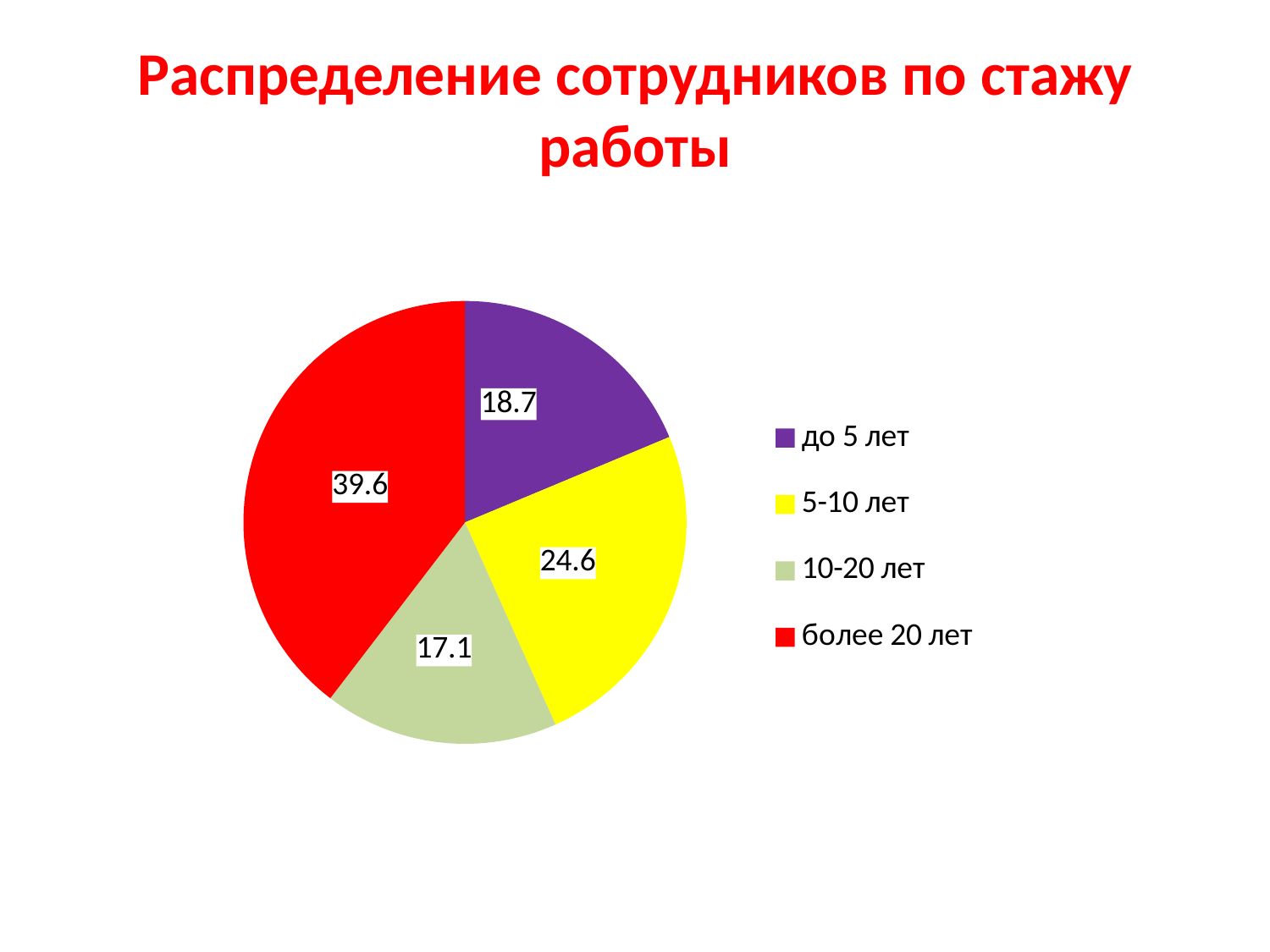
What is the value for the '5-10 лет' slice? 24.6 What is the value for the 'до 5 лет' slice? 18.7 What colour is the 'более 20 лет' slice? red What is the value for the '10-20 лет' slice? 17.1 Which is larger, the value for 'до 5 лет' or the value for '5-10 лет'? 5-10 лет How many slices does the pie chart have? 4 What type of chart is shown on the slide? pie chart What is the difference between the values for 'более 20 лет' and '5-10 лет'? 15 Which category has the smallest slice? 10-20 лет What is the value for the 'более 20 лет' slice? 39.6 Which category has the largest slice? более 20 лет What is the difference between the values for 'до 5 лет' and '10-20 лет'? 1.6